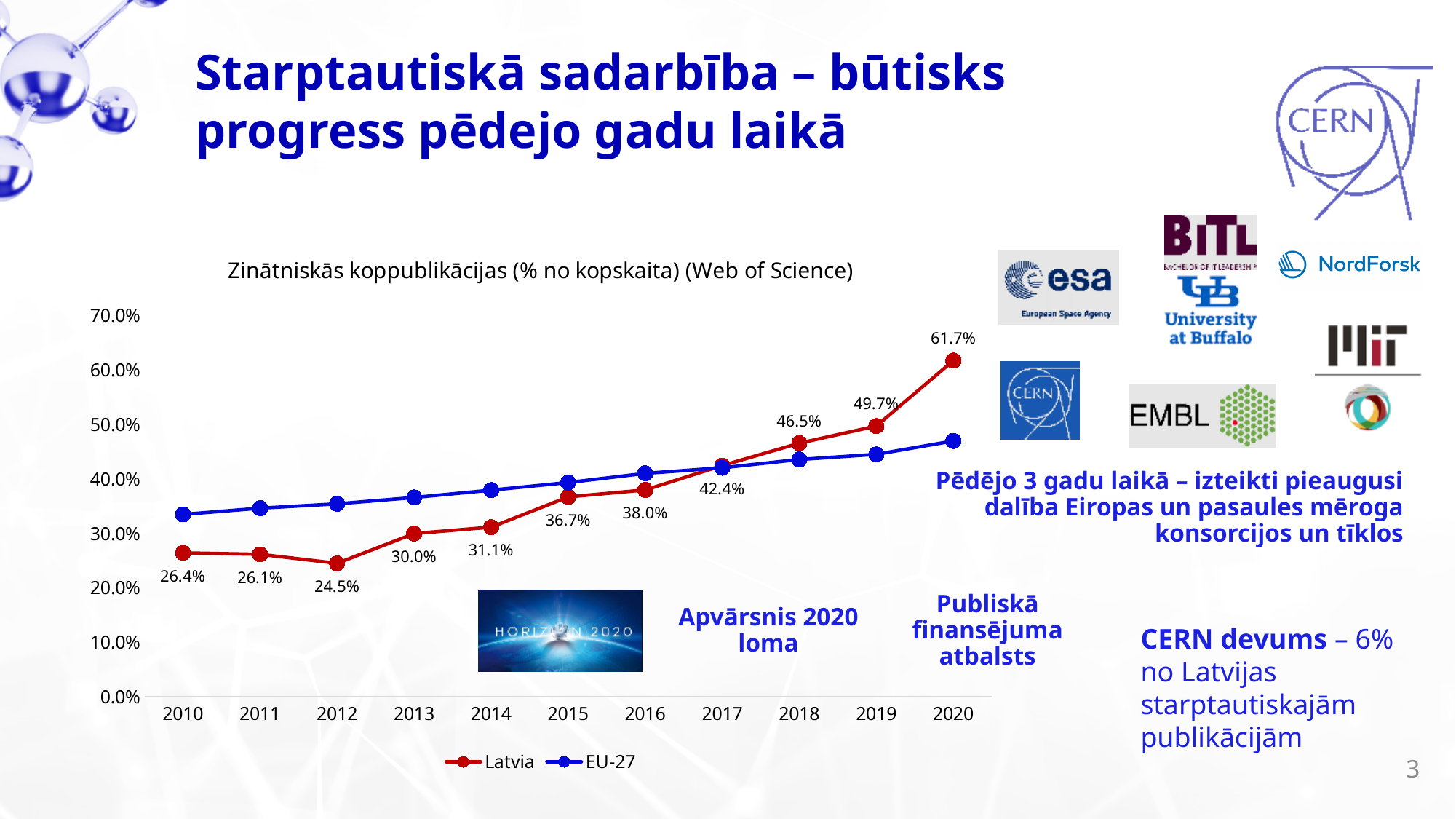
In 2010, which series has the higher value, Latvia or EU-27? EU-27 What kind of chart is shown on the slide? Line chart What is the Latvia value for 2020? 61.7% How many series does the legend list? 2 By how many percentage points did the Latvia value increase from 2019 to 2020? 12.0 percentage points In which year is the Latvia series highest? 2020 Is the EU-27 value for 2020 greater or less than 50.0%? less In which year is the Latvia series lowest? 2012 What is the Latvia value for 2012? 24.5% How many years are shown on the x axis? 11 In 2020, which series has the higher value, Latvia or EU-27? Latvia What is the Latvia value for 2017? 42.4%